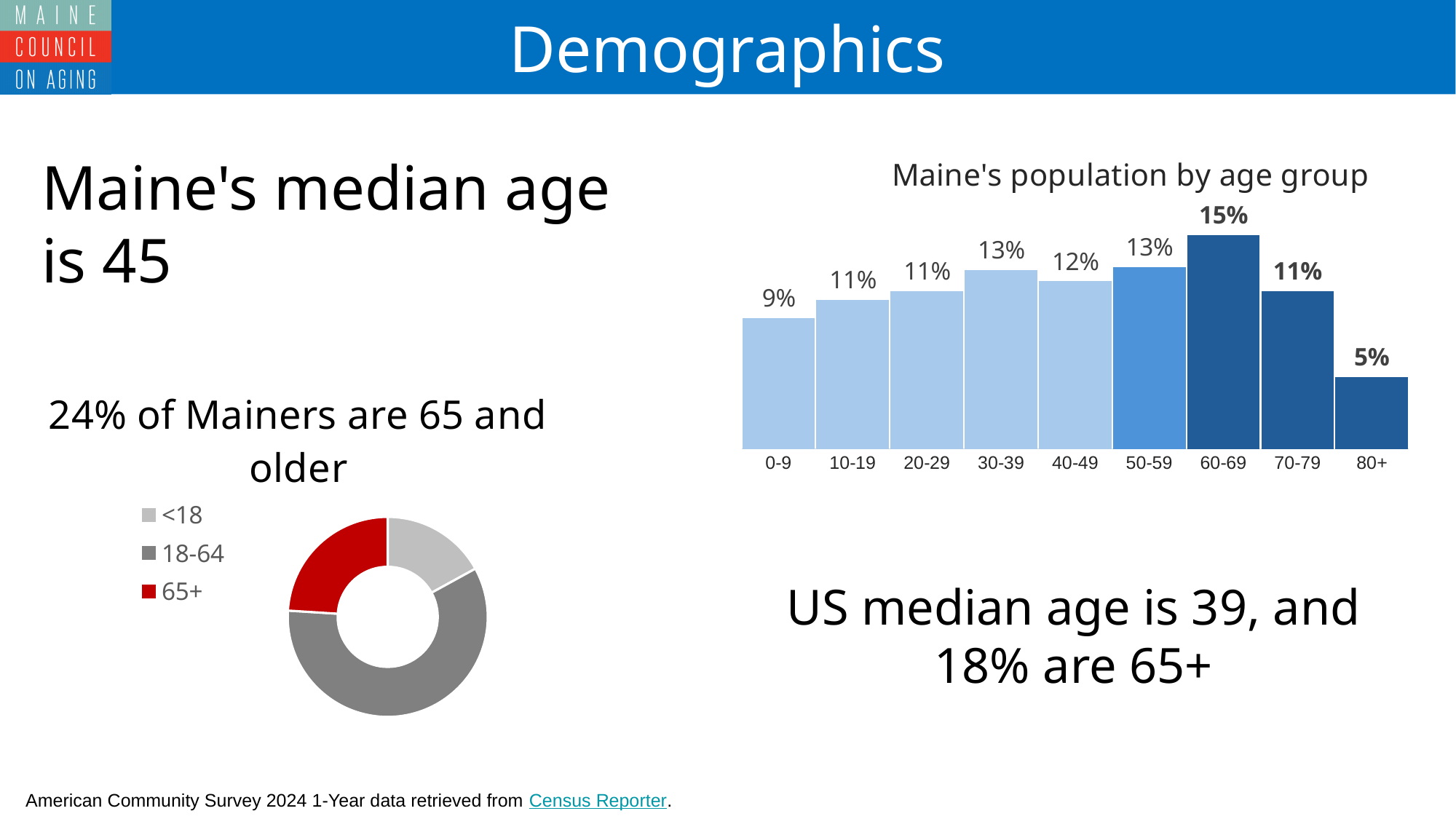
In the 'Maine's population by age group' chart, which age group has the lowest share of the population? 80+ How many age groups are shown in the 'Maine's population by age group' chart? 9 In the 'Maine's population by age group' chart, what percentage of Maine's population is in the 60-69 age group? 15% What kind of chart is 'Maine's population by age group'? Bar chart In the 'Maine's population by age group' chart, what is the value for the 80+ age group? 5% In the 'Maine's population by age group' chart, what is the value for the 0-9 age group? 9% In the 'Maine's population by age group' chart, what is the difference in percentage points between the 60-69 and 80+ age groups? 10 percentage points How many categories does the legend of the '24% of Mainers are 65 and older' chart list? 3 In the '24% of Mainers are 65 and older' chart, which category has the largest slice? 18-64 In the '24% of Mainers are 65 and older' chart, what colour represents the 65+ category? Red In the 'Maine's population by age group' chart, which age group has the highest share of the population? 60-69 In the 'Maine's population by age group' chart, which is larger, the value for 30-39 or the value for 0-9? 30-39